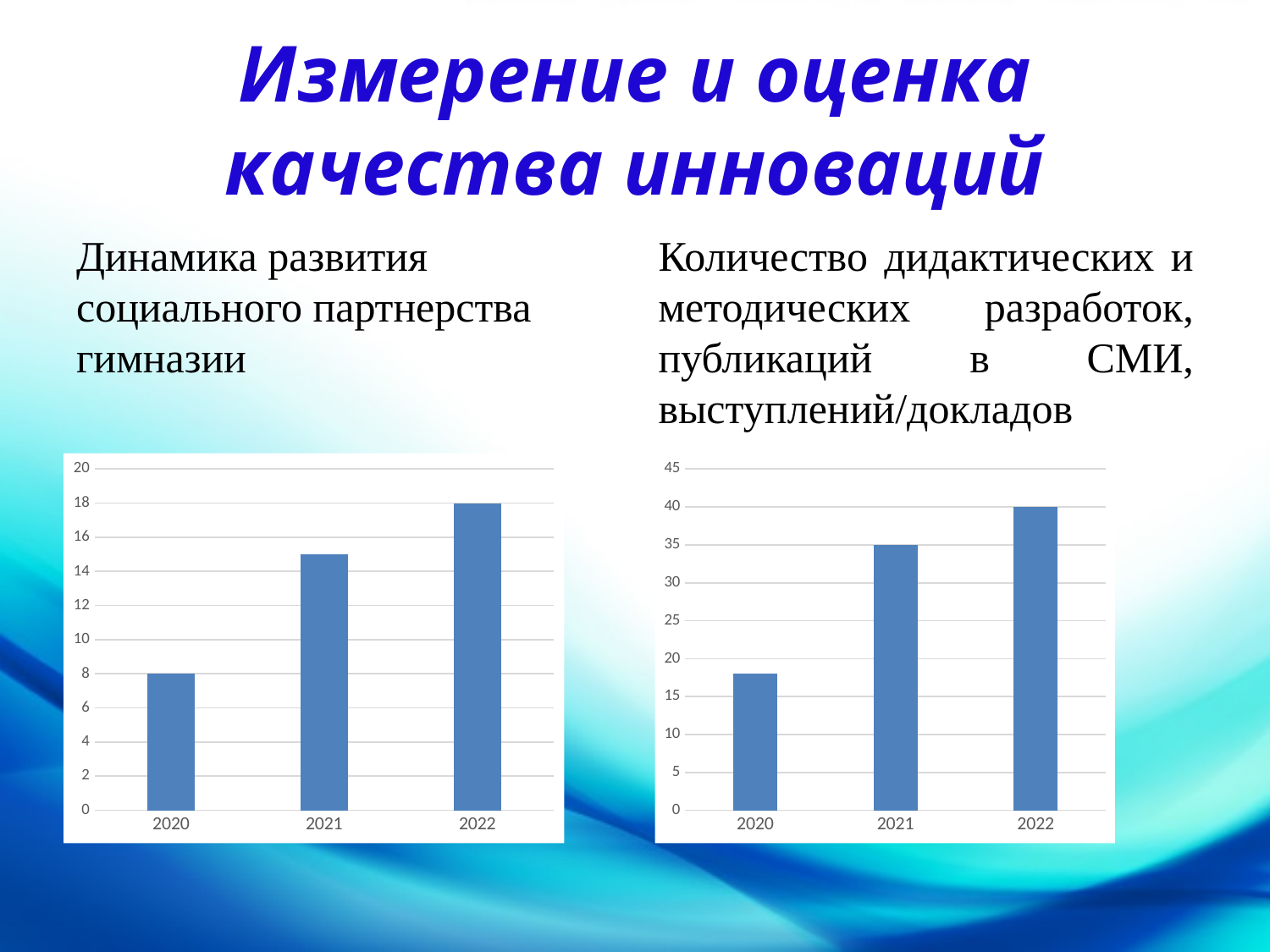
On the left chart, what is the value for 2022? 18 On the right chart, what is the value for 2022? 40 On the left chart, what is the difference between the values for 2022 and 2020? 10 On the left chart (Динамика развития социального партнерства гимназии), what is the value for 2020? 8 On the right chart, is the value for 2020 greater or less than 20? less On the right chart, which year has the lowest value? 2020 On the left chart, which year has the highest value? 2022 On the left chart, do the values rise or fall from 2020 to 2022? rise On the left chart, is the value for 2021 greater or less than 14? greater On the right chart (Количество дидактических и методических разработок, публикаций в СМИ, выступлений/докладов), what is the value for 2021? 35 On the right chart, what is the difference between the values for 2022 and 2021? 5 How many categories are shown on the right chart? 3